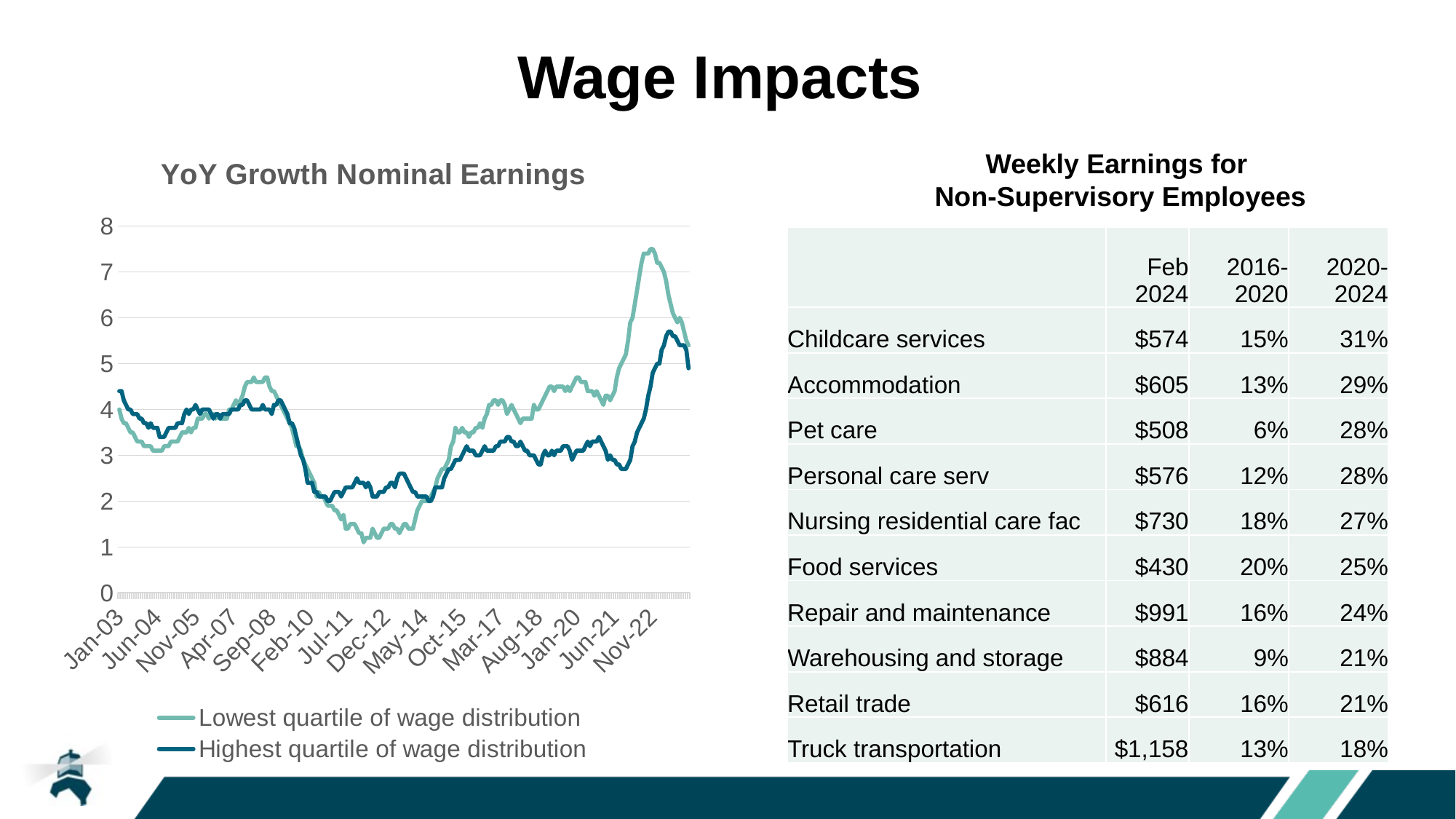
Which series in the 'YoY Growth Nominal Earnings' chart is drawn in the darker line? Highest quartile of wage distribution What is the title of the chart on the left of the slide? YoY Growth Nominal Earnings In the 'YoY Growth Nominal Earnings' chart, do the values for both series rise or fall between Sep-08 and Jul-11? fall In the 'YoY Growth Nominal Earnings' chart, which series is higher around Dec-12? Highest quartile of wage distribution In the 'YoY Growth Nominal Earnings' chart, is the value for the highest quartile of wage distribution at Jan-03 greater or less than 4? greater What kind of chart is the 'YoY Growth Nominal Earnings' chart? line chart What is the highest tick value shown on the y axis of the 'YoY Growth Nominal Earnings' chart? 8 In the 'YoY Growth Nominal Earnings' chart, is the value for the lowest quartile of wage distribution around Dec-12 greater or less than 2? less In the 'YoY Growth Nominal Earnings' chart, which series reaches the highest peak overall? Lowest quartile of wage distribution How many series does the legend of the 'YoY Growth Nominal Earnings' chart list? 2 In the 'YoY Growth Nominal Earnings' chart, is the peak value of the lowest quartile of wage distribution around Nov-22 greater or less than 7? greater